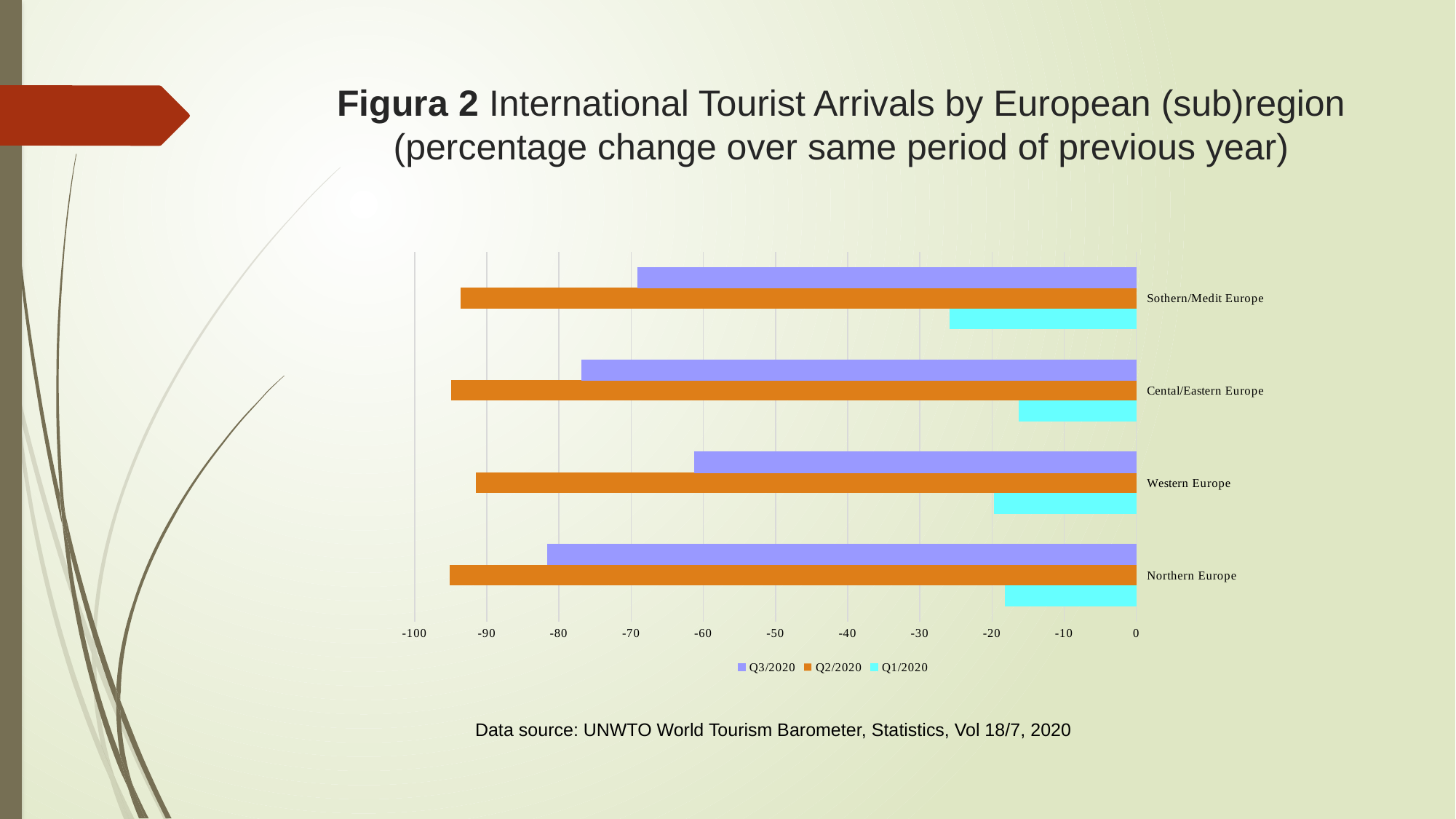
Which series is drawn in orange? Q2/2020 Is the Q1/2020 value for Cental/Eastern Europe greater or less than -20? greater How many series does the legend list? 3 Which region has the lowest (most negative) Q1/2020 value? Sothern/Medit Europe Is the Q3/2020 value for Western Europe greater or less than -70? greater How many European (sub)regions are shown on the chart? 4 Is the Q3/2020 value for Northern Europe greater or less than -70? less Which region has the highest (least negative) Q3/2020 value? Western Europe Which is larger, the Q3/2020 value for Western Europe or the Q3/2020 value for Northern Europe? Western Europe What kind of chart is shown on the slide? bar chart